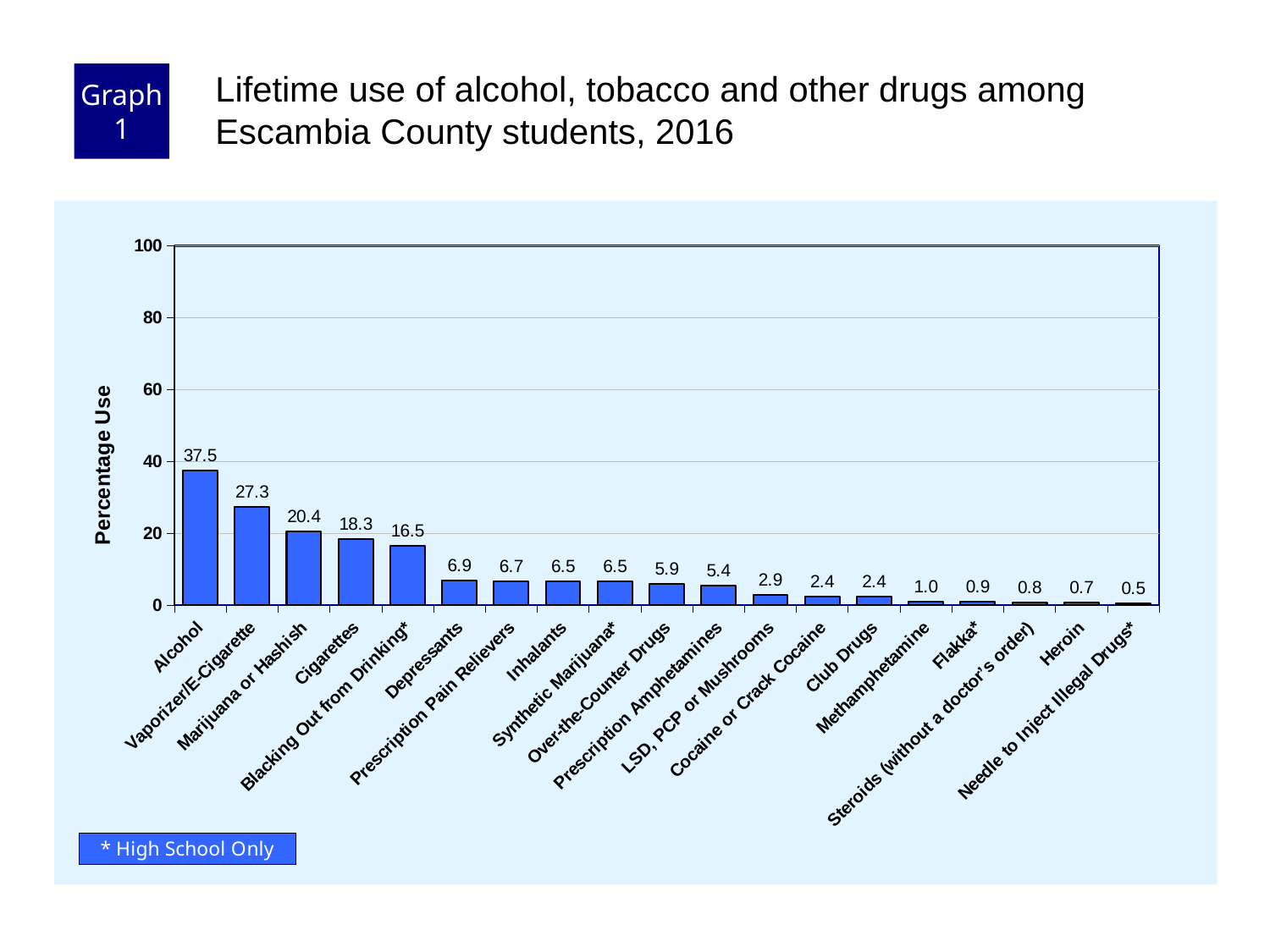
What is the difference between the values for Alcohol and Vaporizer/E-Cigarette? 10.2 What is the value shown for Heroin? 0.7 Which category has the highest value? Alcohol What is the value shown for Prescription Amphetamines? 5.4 What is the label on the y axis? Percentage Use What is the value shown for Cigarettes? 18.3 How many categories are shown on the x axis? 19 Is the value for Vaporizer/E-Cigarette greater or less than 20? greater What is the lifetime use percentage for Alcohol? 37.5 What kind of chart is shown on the slide? Bar chart Which category has the lowest value? Needle to Inject Illegal Drugs* Which is larger, the value for Marijuana or Hashish or the value for Blacking Out from Drinking*? Marijuana or Hashish